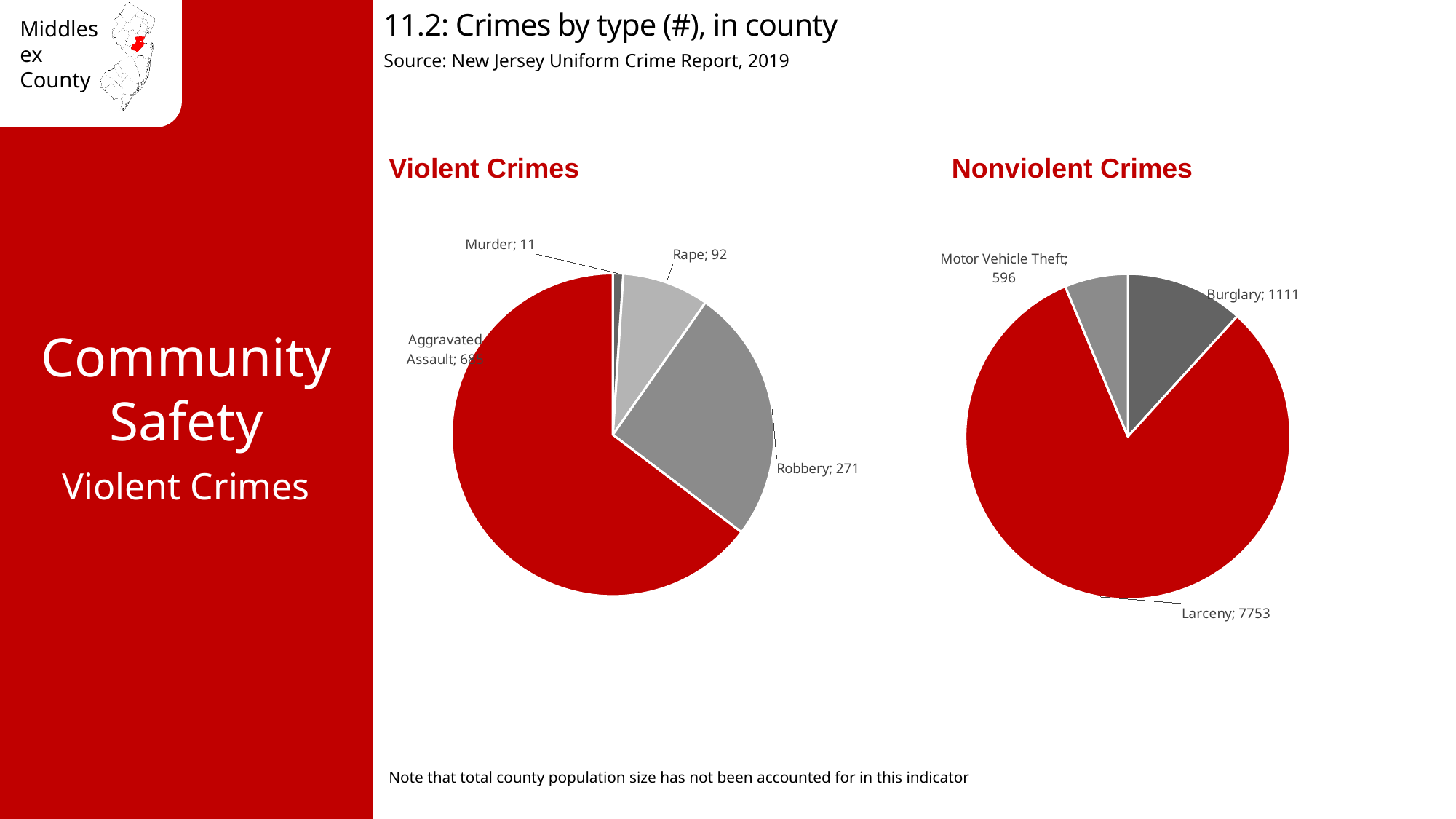
In the Violent Crimes chart, how many robberies are shown? 271 In the Nonviolent Crimes chart, which is larger, Burglary or Motor Vehicle Theft? Burglary In the Violent Crimes chart, which crime type has the smallest slice? Murder In the Violent Crimes chart, how many more robberies than rapes are shown? 179 In the Violent Crimes chart, what is the value for Rape? 92 In the Violent Crimes chart, what is the value for Murder? 11 In the Nonviolent Crimes chart, what is the value for Motor Vehicle Theft? 596 How many crime types are shown in the Violent Crimes pie chart? 4 In the Nonviolent Crimes chart, what is the difference between Burglary and Motor Vehicle Theft? 515 What type of chart is used for the Violent Crimes data? Pie chart In the Violent Crimes chart, which crime type has the largest slice? Aggravated Assault In the Nonviolent Crimes chart, what is the value for Larceny? 7753